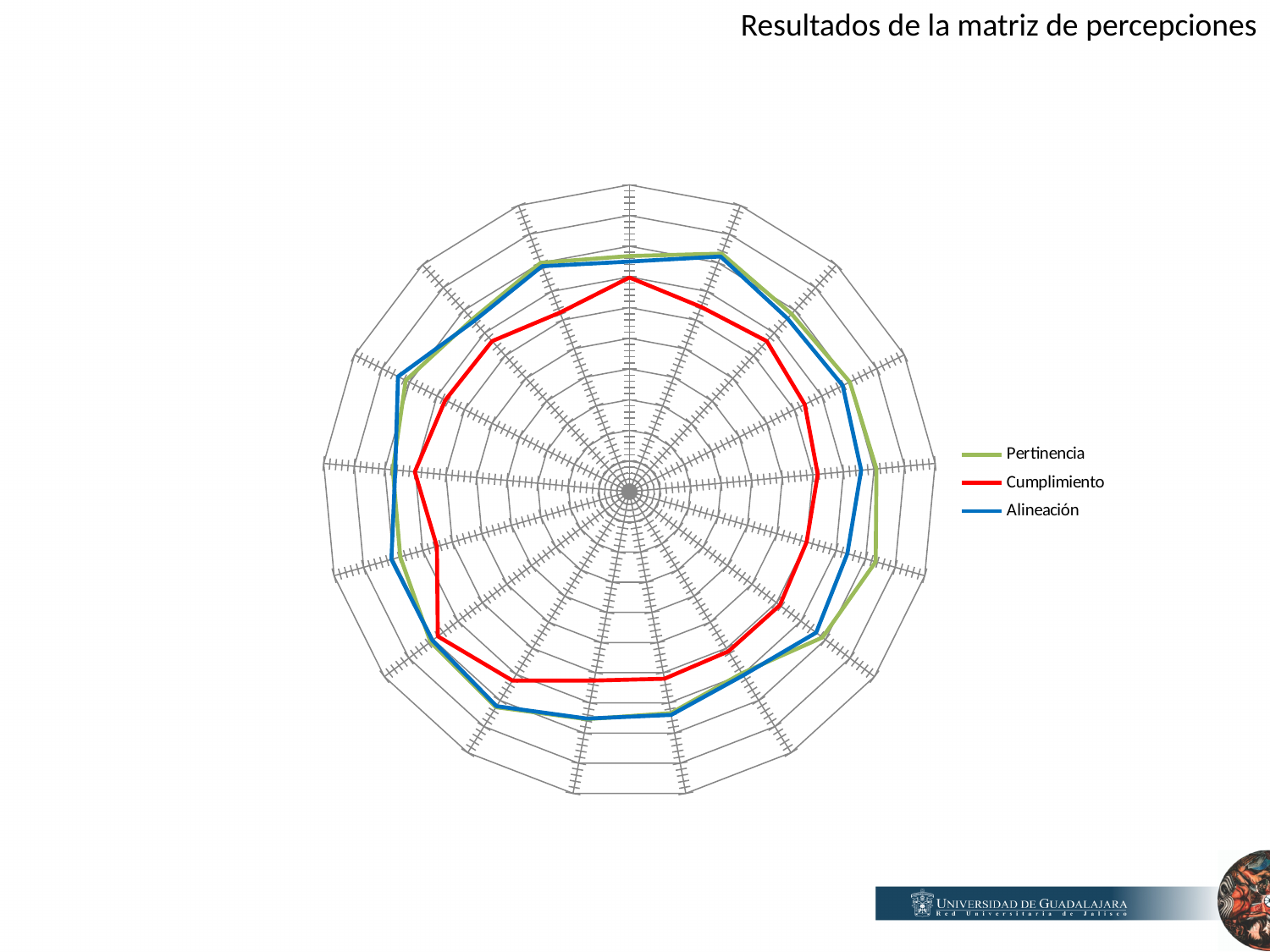
What is the title of the slide containing the chart? Resultados de la matriz de percepciones How many series does the legend list? 3 What kind of chart is shown on the slide? Radar chart Which series has the smallest values overall, lying innermost on the radar chart? Cumplimiento Which series is drawn in red? Cumplimiento Which series has larger values overall, Cumplimiento or Pertinencia? Pertinencia